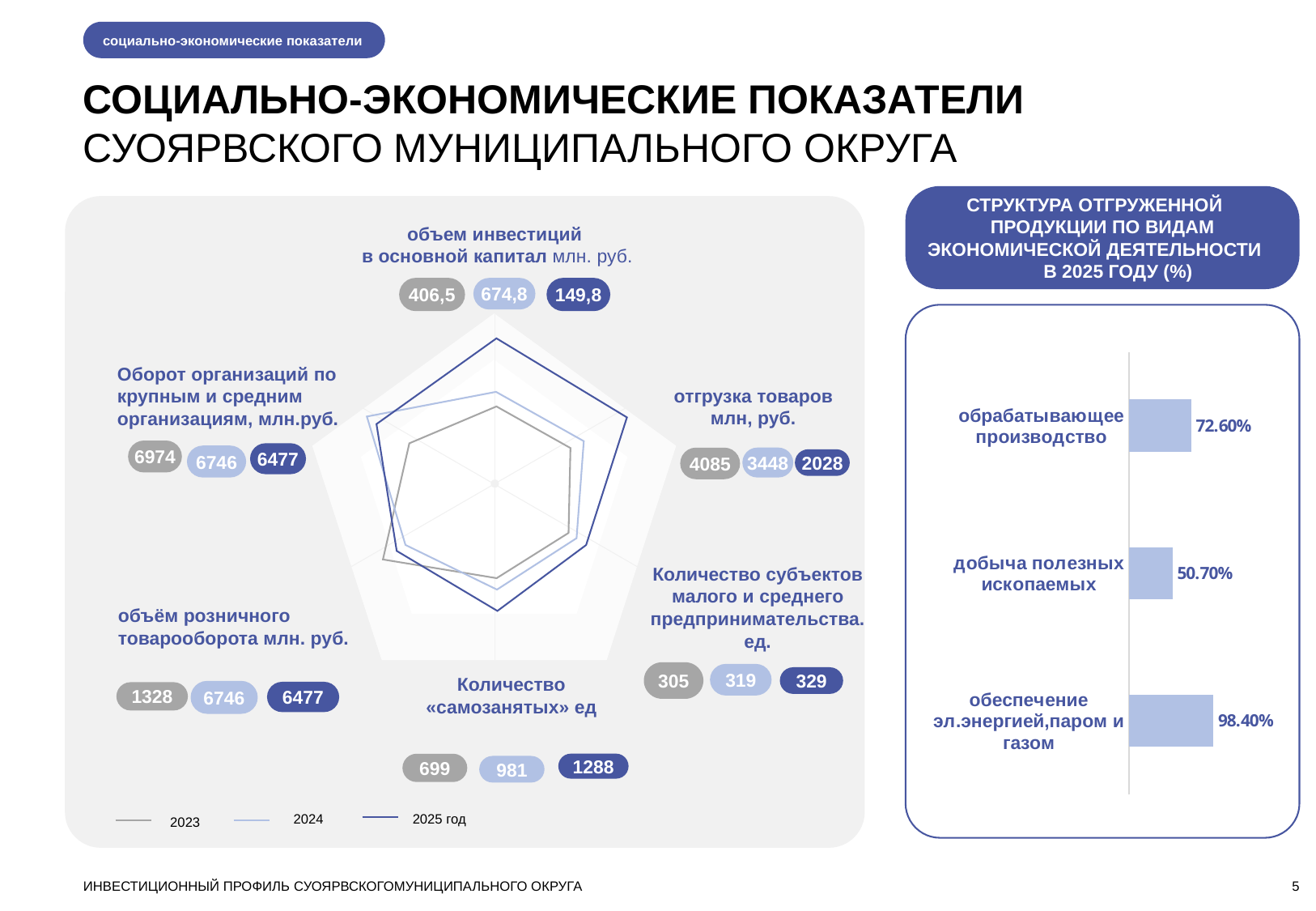
In the radar chart on the left, do the values for Количество «самозанятых» rise or fall from 2023 to 2025? rise In the bar chart on the right, how many categories are shown? 3 In the radar chart on the left, how many series does the legend list? 3 In the bar chart on the right, what is the difference between the values for обеспечение эл.энергией, паром и газом and добыча полезных ископаемых? 47.70 percentage points In the radar chart on the left, which year has the larger value for Количество субъектов малого и среднего предпринимательства: 2024 or 2025? 2025 What kind of chart is shown on the right side of the slide? bar chart In the bar chart on the right, which category has the highest value? обеспечение эл.энергией, паром и газом In the radar chart on the left, what is the value for Количество «самозанятых» in 2025? 1288 In the bar chart on the right, which category has the lowest value? добыча полезных ископаемых In the bar chart on the right (Структура отгруженной продукции), what is the value for обрабатывающее производство? 72.60% In the radar chart on the left, what is the value for отгрузка товаров in 2023? 4085 What kind of chart is shown on the left side of the slide? radar chart